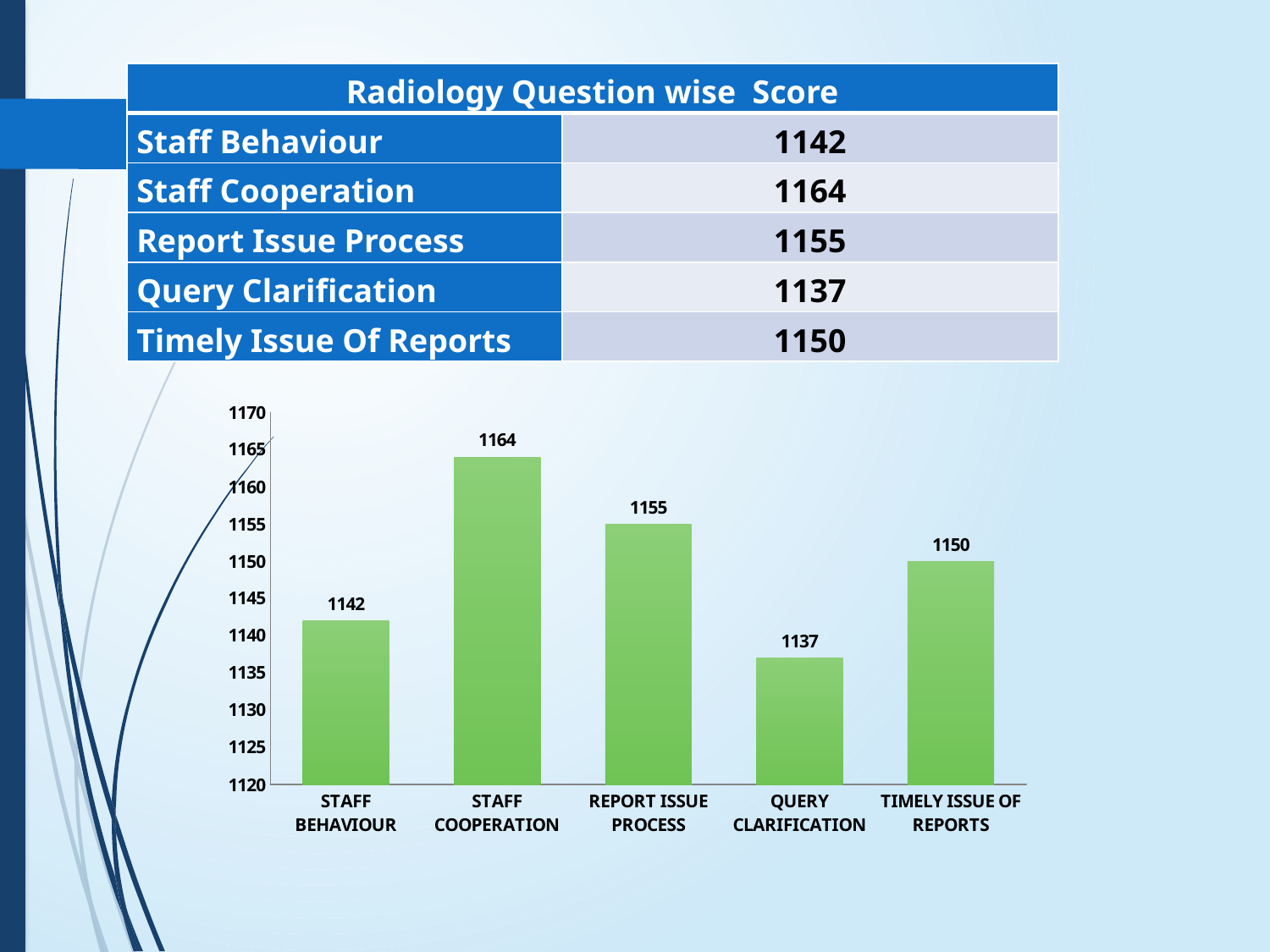
How many categories are shown in the bar chart? 5 What is the value for Staff Cooperation in the bar chart? 1164 What is the value for Timely Issue of Reports in the bar chart? 1150 Is the value for Staff Behaviour greater or less than 1140? greater Which category has the lowest value in the bar chart? Query Clarification What is the difference between the values for Report Issue Process and Staff Behaviour? 13 What is the difference between the values for Staff Cooperation and Query Clarification? 27 Which is larger, the value for Report Issue Process or the value for Timely Issue of Reports? Report Issue Process What kind of chart is shown on the slide? bar chart What is the value for Query Clarification in the bar chart? 1137 Which category has the highest value in the bar chart? Staff Cooperation What is the title of the table above the chart? Radiology Question wise Score